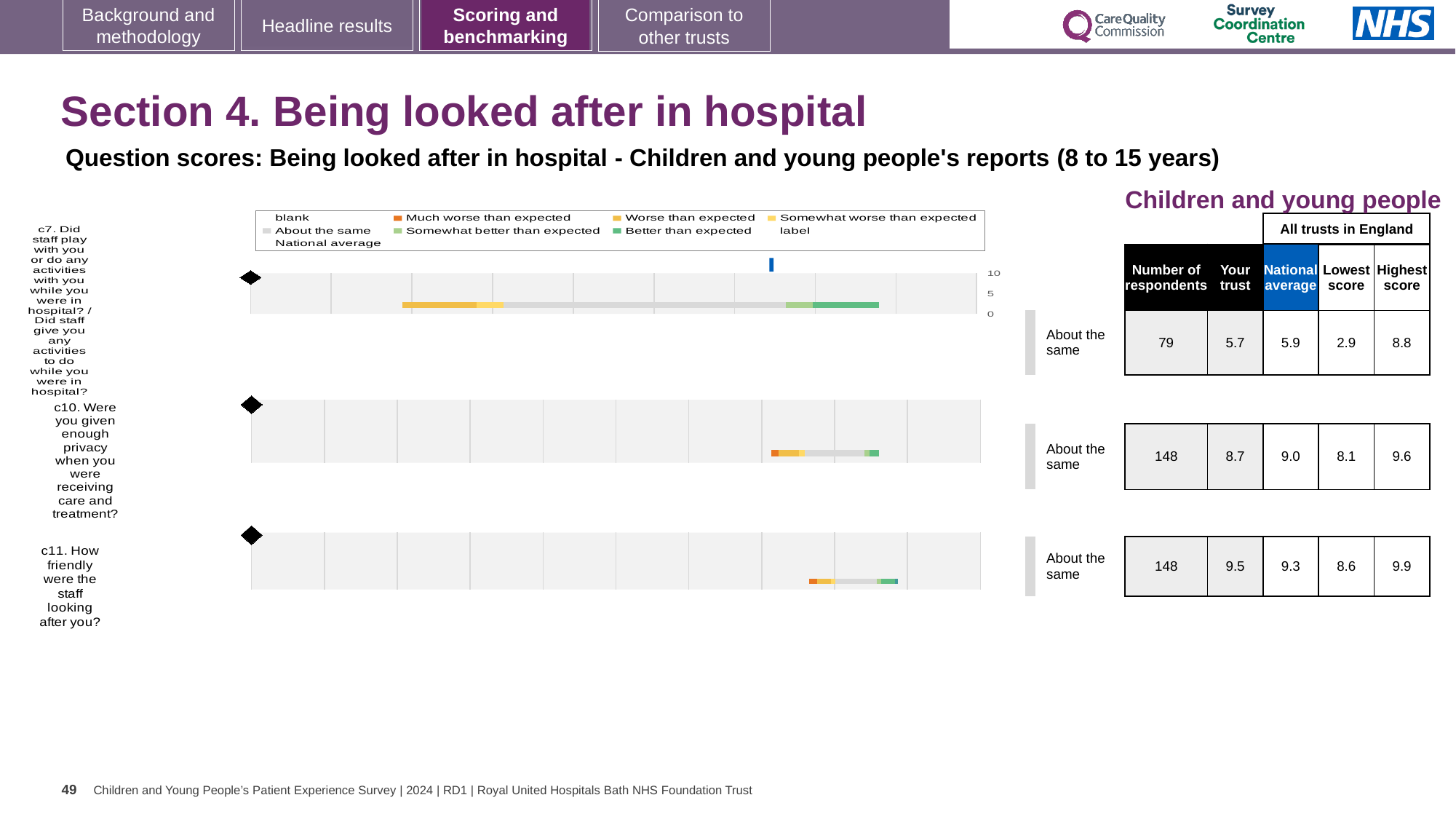
What is the 'Your trust' score for question c7 (Did staff play with you or do any activities with you while you were in hospital?)? 5.7 What benchmark category is shown for all three questions on this slide? About the same Which question has the lowest 'Your trust' score? c7. Did staff play with you or do any activities with you while you were in hospital? For question c11, is the 'Your trust' score or the national average higher? Your trust How many questions are plotted in the benchmark charts on this slide? 3 Which question has the highest 'Your trust' score? c11. How friendly were the staff looking after you? What is the national average score for question c10 (Were you given enough privacy when you were receiving care and treatment?)? 9.0 What kind of chart is used to show the question scores on this slide? bar chart For question c10, what is the difference between the national average and the 'Your trust' score? 0.3 What is the highest score among all trusts in England for question c11 (How friendly were the staff looking after you?)? 9.9 How many respondents answered question c7? 79 Is the 'Your trust' score for question c7 greater or less than 5 on the chart axis? greater